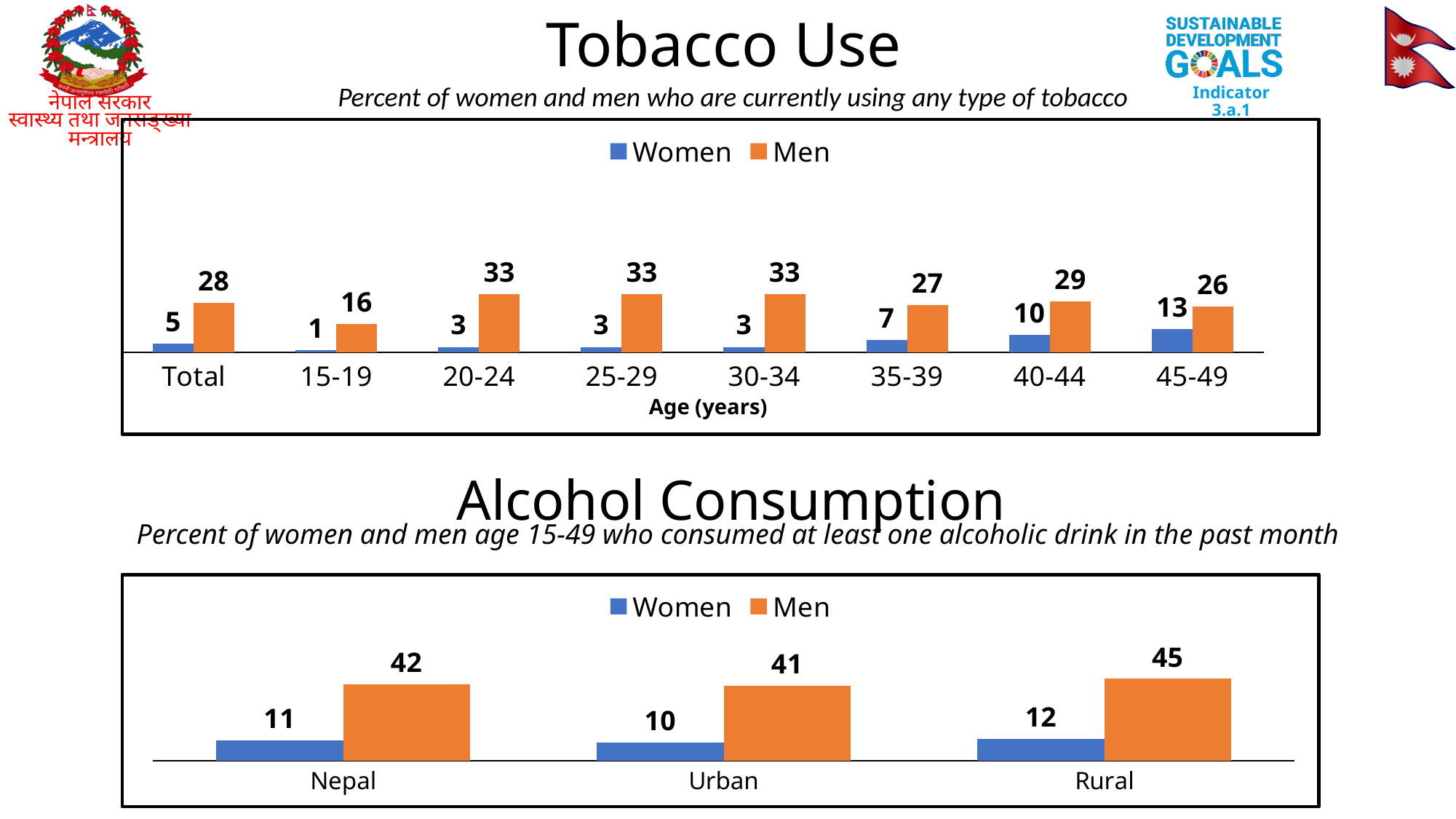
In the Tobacco Use chart, what is the difference between the Men and Women values for the Total category? 23 In the Tobacco Use chart, what is the value for Women in the 45-49 age group? 13 What kind of chart is the Alcohol Consumption chart? bar chart In the Tobacco Use chart, which age group has the lowest value for Men? 15-19 In the Alcohol Consumption chart, how many series does the legend list? 2 In the Alcohol Consumption chart, what is the value for Men in Rural areas? 45 In the Alcohol Consumption chart, which category has the lowest value for Women? Urban In the Tobacco Use chart, which age group has the highest value for Women? 45-49 In the Tobacco Use chart, what is the value for Men in the 15-19 age group? 16 In the Tobacco Use chart, do the Women values rise or fall from the 20-24 age group to the 45-49 age group? rise In the Alcohol Consumption chart, is the value for Men in Nepal larger or smaller than the value for Men in Urban areas? larger In the Tobacco Use chart, how many age categories are shown on the x axis? 8